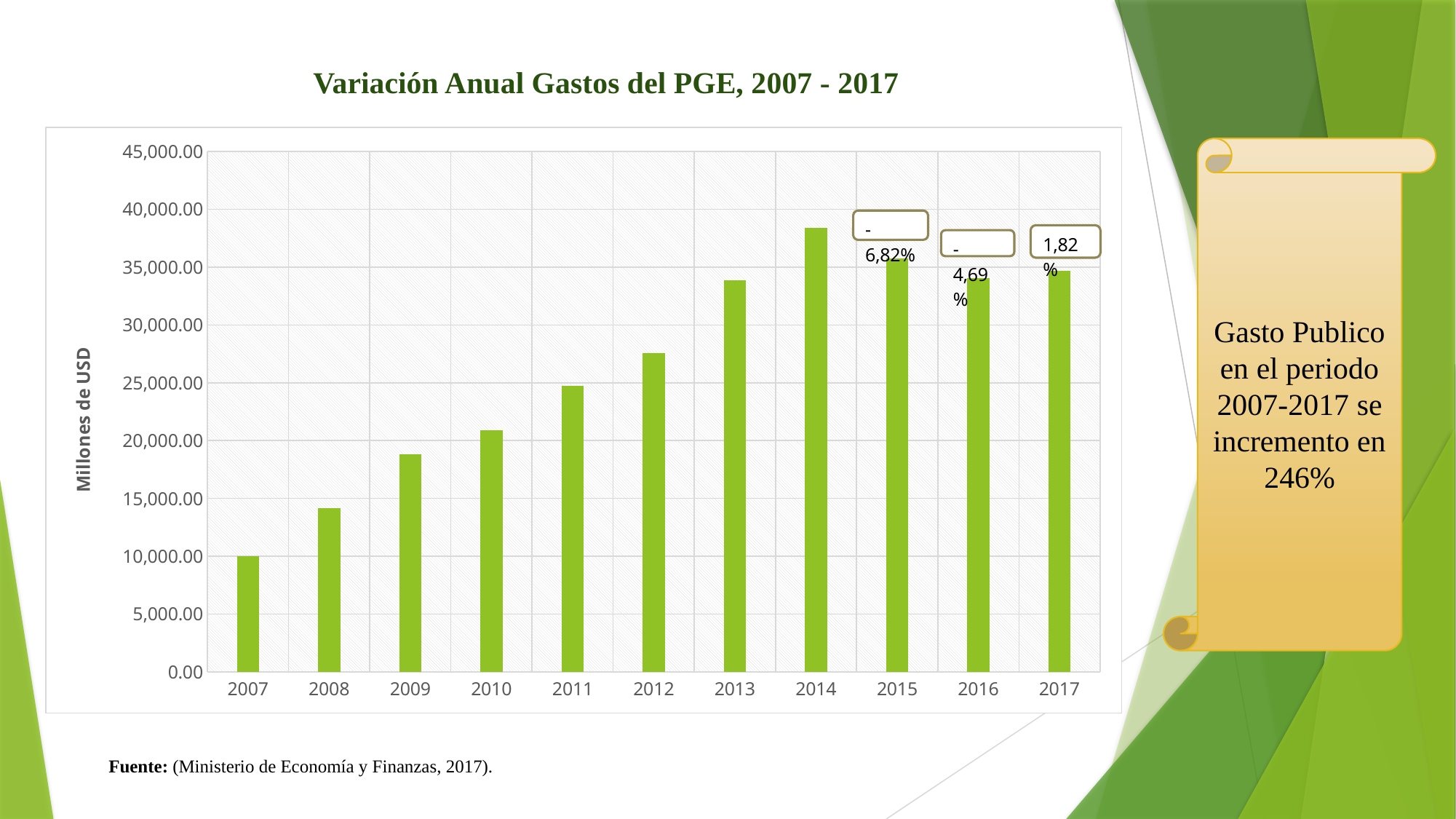
Which year has the highest bar in the chart? 2014 How many years are shown on the x axis of the chart? 11 Which year has the lowest bar in the chart? 2007 What kind of chart is shown on the slide? bar chart Is the value for 2008 greater or less than 15,000.00? less Is the value for 2014 greater or less than 35,000.00? greater Which year has the larger value, 2009 or 2010? 2010 Is the value for 2016 greater or less than 35,000.00? less Which year has the larger value, 2014 or 2015? 2014 Do the values rise or fall from 2007 to 2014? rise What is the label on the vertical axis of the chart? Millones de USD